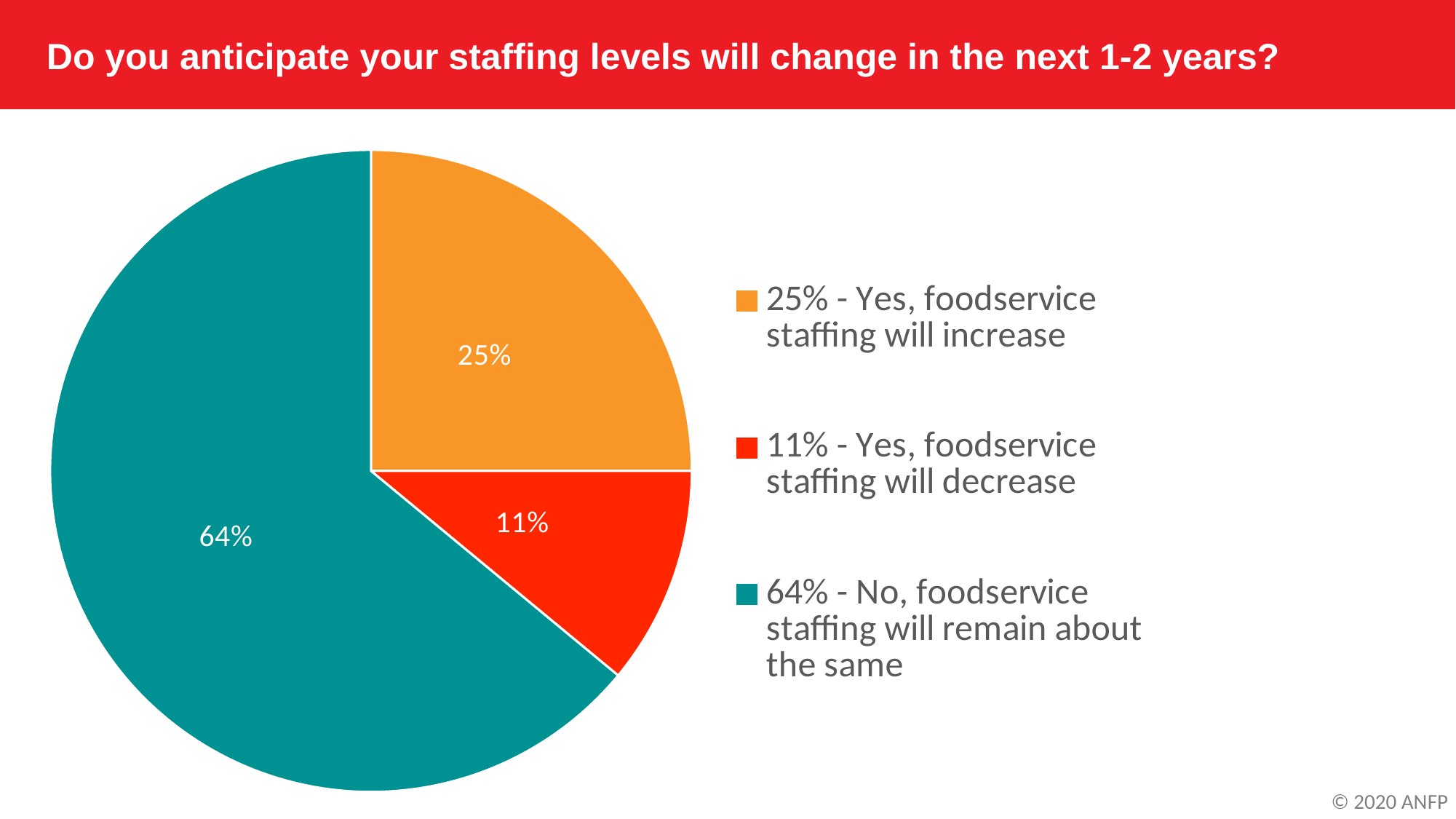
What kind of chart is shown on the slide? Pie chart Which response has the smallest share of the pie? Yes, foodservice staffing will decrease What is the difference in percentage points between the 'will increase' slice and the 'will decrease' slice? 14 What colour is the slice for 'No, foodservice staffing will remain about the same'? Teal What is the title of the slide? Do you anticipate your staffing levels will change in the next 1-2 years? Which is larger: the share saying staffing will increase or the share saying staffing will decrease? Staffing will increase What is the difference in percentage points between the 'remain about the same' slice and the 'will increase' slice? 39 What percentage of respondents said foodservice staffing will decrease? 11% How many slices does the pie chart have? 3 What percentage of respondents said foodservice staffing will remain about the same? 64% What percentage of respondents said foodservice staffing will increase? 25% Which response has the largest share of the pie? No, foodservice staffing will remain about the same